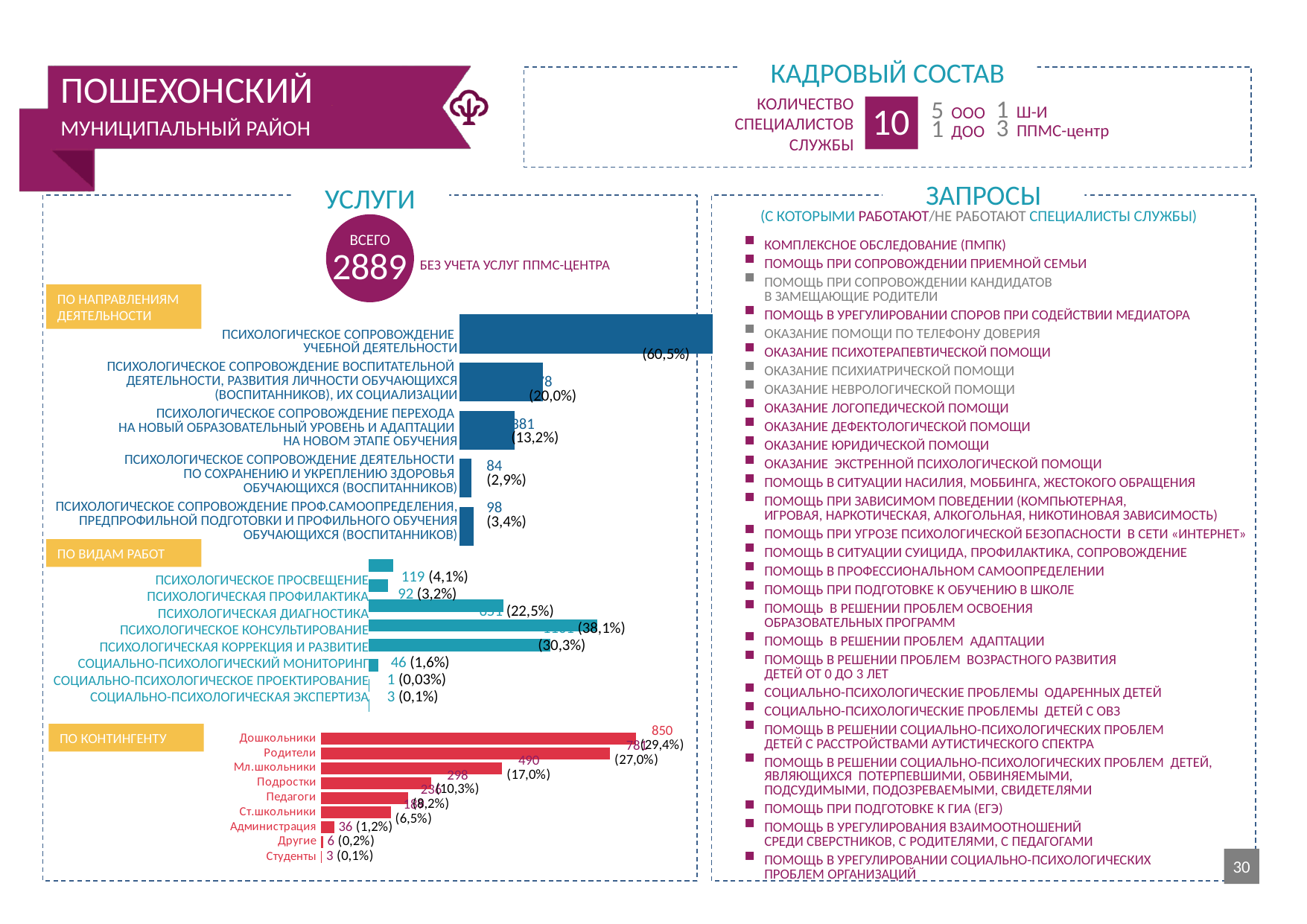
In the 'ПО КОНТИНГЕНТУ' chart, what value is shown for 'Дошкольники'? 850 (29,4%) In the 'ПО ВИДАМ РАБОТ' chart, how many categories are plotted? 8 In the 'ПО КОНТИНГЕНТУ' chart, which is larger: the value for 'Мл.школьники' or for 'Подростки'? Мл.школьники In the 'ПО НАПРАВЛЕНИЯМ ДЕЯТЕЛЬНОСТИ' chart, how many categories are plotted? 5 In the 'ПО КОНТИНГЕНТУ' chart, what is the difference between the values for 'Администрация' and 'Другие'? 30 In the 'ПО ВИДАМ РАБОТ' chart, what percentage is shown for 'Психологическое консультирование'? 38,1% In the 'ПО НАПРАВЛЕНИЯМ ДЕЯТЕЛЬНОСТИ' chart, which category has the longest bar? Психологическое сопровождение учебной деятельности What kind of chart is the 'ПО КОНТИНГЕНТУ' chart? Bar chart In the 'ПО НАПРАВЛЕНИЯМ ДЕЯТЕЛЬНОСТИ' chart, what value is shown for 'Психологическое сопровождение деятельности по сохранению и укреплению здоровья обучающихся (воспитанников)'? 84 (2,9%) In the 'ПО НАПРАВЛЕНИЯМ ДЕЯТЕЛЬНОСТИ' chart, what percentage is shown for 'Психологическое сопровождение учебной деятельности'? 60,5% In the 'ПО ВИДАМ РАБОТ' chart, what value is shown for 'Психологическое просвещение'? 119 (4,1%) In the 'ПО ВИДАМ РАБОТ' chart, which category has the smallest value? Социально-психологическое проектирование